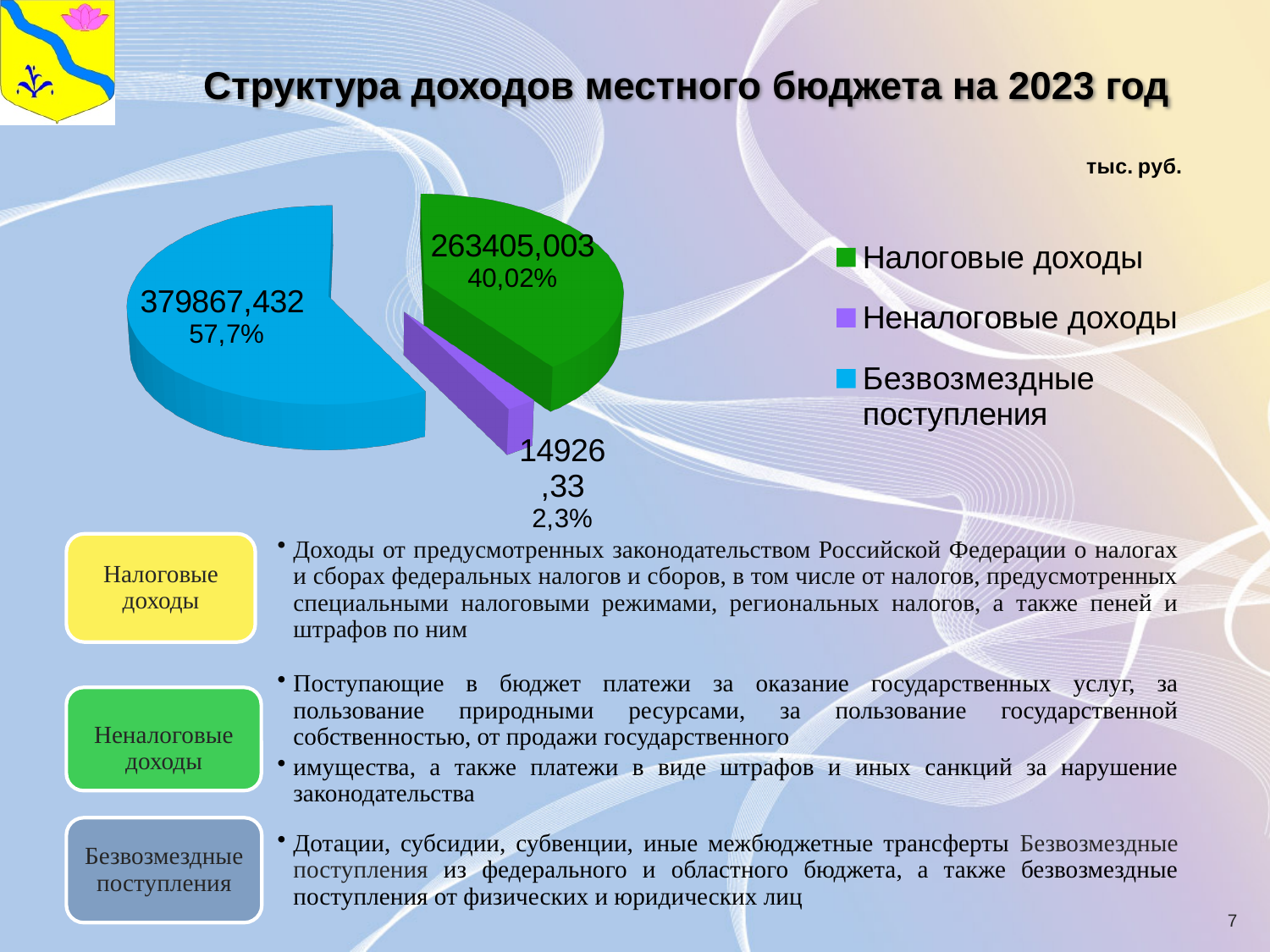
What type of chart is shown on the slide? Pie chart What share of the pie does Налоговые доходы represent? 40,02% What is the value for Неналоговые доходы in the pie chart? 14926,33 What is the value for Безвозмездные поступления in the pie chart? 379867,432 Which category has the smallest slice in the pie chart? Неналоговые доходы Which category has the largest slice in the pie chart? Безвозмездные поступления What share of the pie does Неналоговые доходы represent? 2,3% Which is larger: Налоговые доходы or Безвозмездные поступления? Безвозмездные поступления What share of the pie does Безвозмездные поступления represent? 57,7% What unit is indicated for the values in the chart? тыс. руб. What is the value for Налоговые доходы in the pie chart? 263405,003 How many categories does the pie chart show? 3